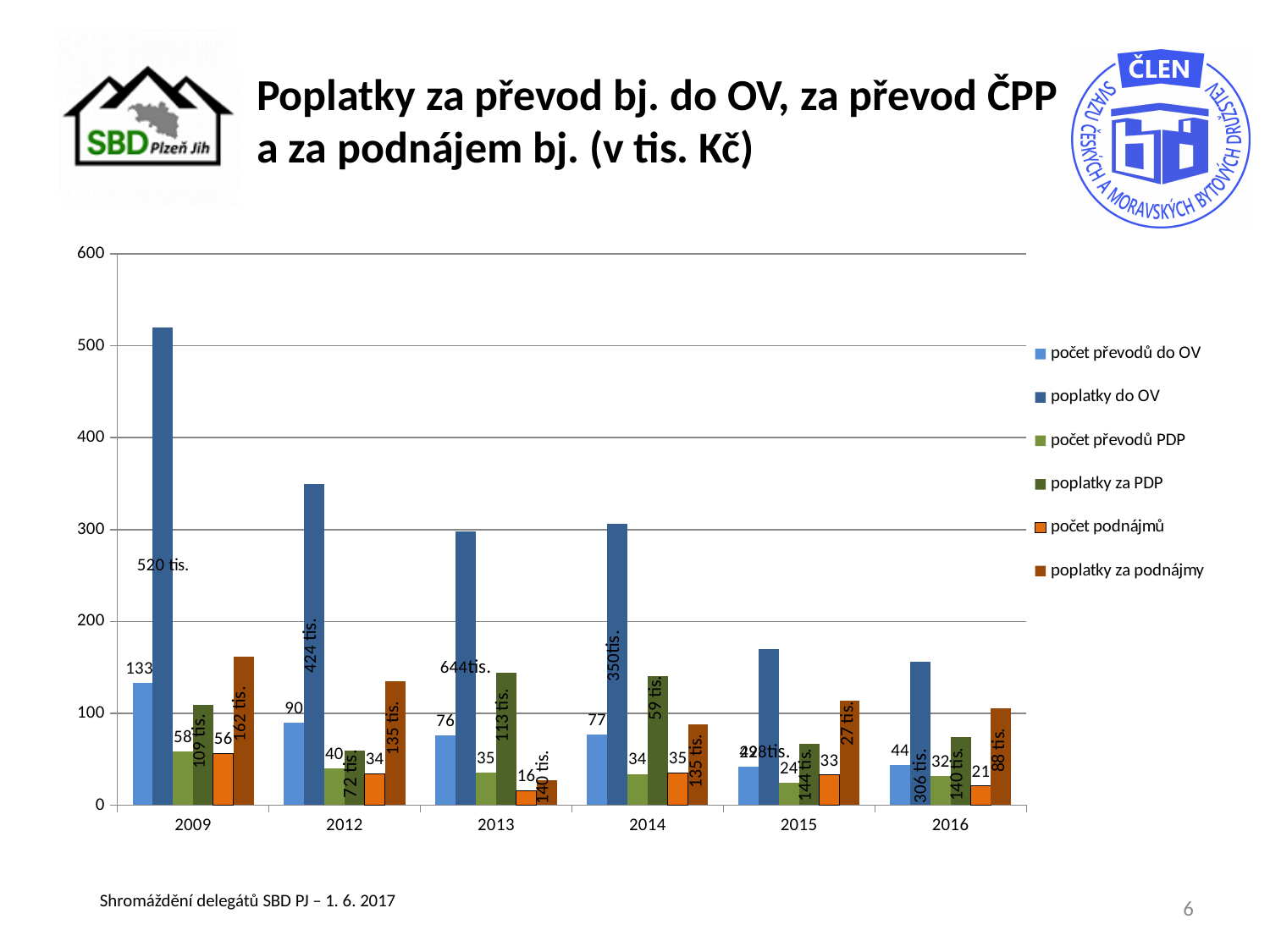
In which year is the 'poplatky do OV' bar the tallest? 2009 How many years are shown on the x axis of the chart? 6 What is the first entry in the chart legend? počet převodů do OV Is the 'poplatky do OV' bar for 2015 greater or less than 200 on the axis? less What kind of chart is shown on the slide? bar chart What is the value of 'počet podnájmů' for 2016? 21 What is the data label for 'poplatky do OV' in 2009? 520 tis. How many series does the chart legend list? 6 What is the data label for 'poplatky za podnájmy' in 2009? 162 tis. What is the difference between 'počet převodů do OV' in 2009 (133) and in 2012 (90)? 43 Which is larger, 'počet převodů do OV' in 2009 or in 2012? 2009 What is the value of 'počet převodů do OV' for 2009? 133